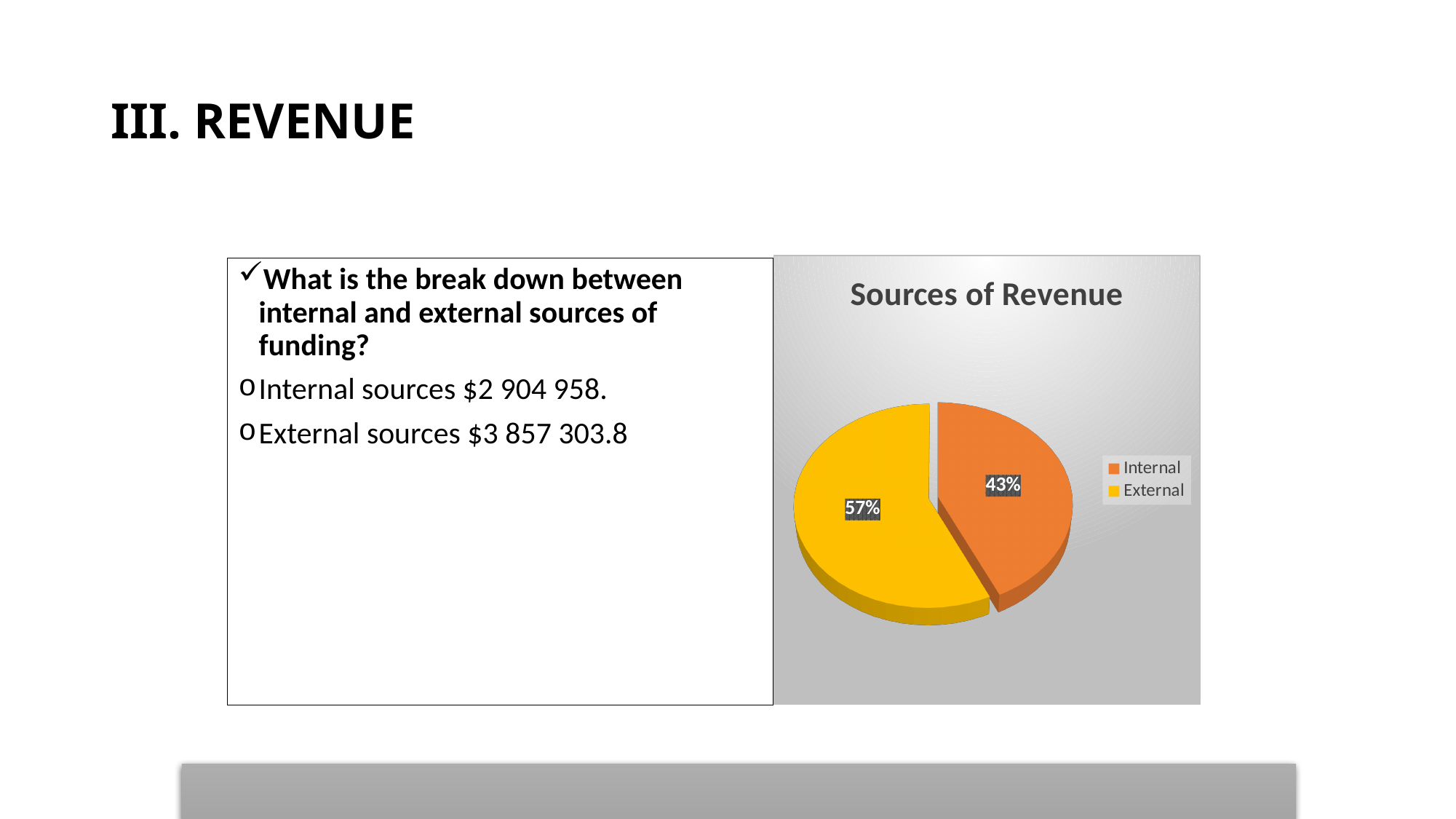
Which colour represents the External slice? yellow How many entries does the legend list? 2 Which source has the larger share of revenue? External What share of the pie does the External slice represent? 57% What is the title of the chart? Sources of Revenue What share of the pie does the Internal slice represent? 43% What is the difference in percentage points between the External and Internal shares? 14 percentage points Which source has the smaller share of revenue? Internal Is the share for Internal larger or smaller than the share for External? smaller What kind of chart is shown on the slide? pie chart How many slices does the pie chart have? 2